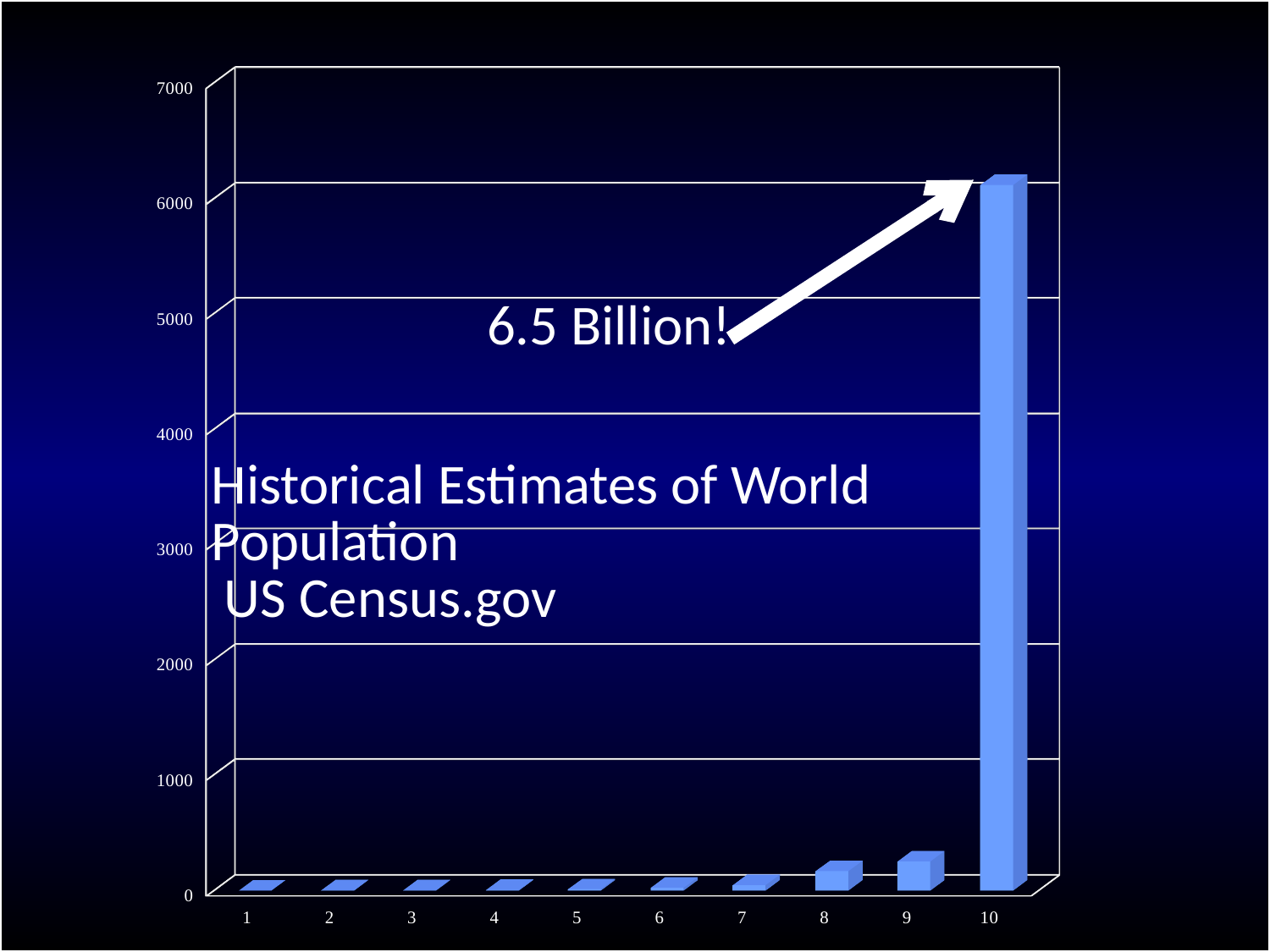
What text does the arrow annotation on the chart point to the tallest bar with? 6.5 Billion! Which is larger, the value for category 9 or the value for category 10? 10 Which category has the highest bar in the chart? 10 Which is larger, the value for category 8 or the value for category 9? 9 What is the highest value shown on the y axis of the chart? 7000 Is the value for category 10 greater or less than 5000? greater Do the values generally rise or fall from category 1 to category 10? rise How many categories are shown along the x axis of the chart? 10 Is the value for category 9 greater or less than 1000? less What kind of chart is shown on the slide? bar chart Is the value for category 8 greater or less than 1000? less